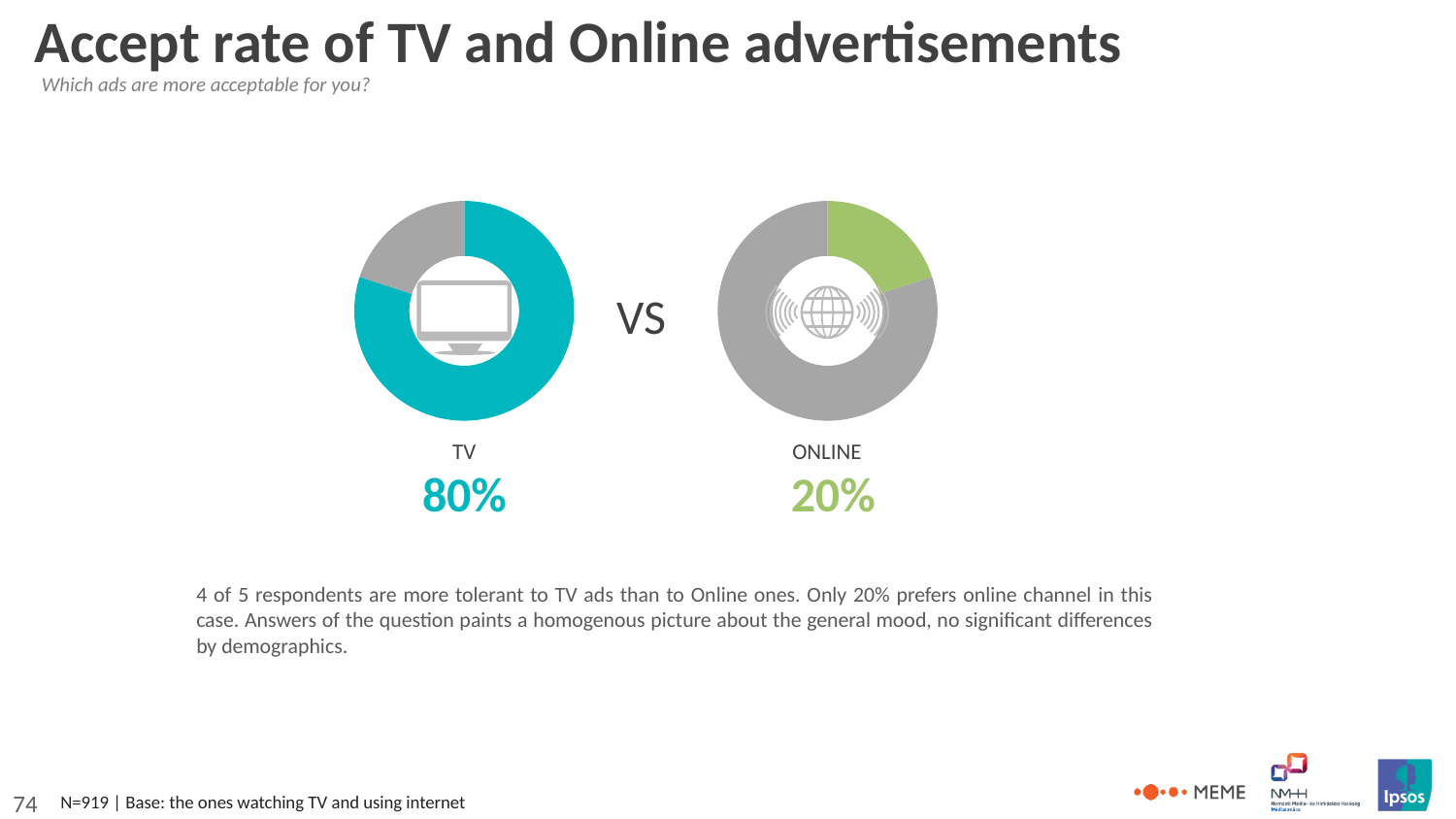
What share of the Online donut chart is filled with the coloured (green) segment? 20% What is the title of the slide containing the charts? Accept rate of TV and Online advertisements What is the accept rate shown for TV advertisements? 80% Which channel has the lower accept rate? Online What colour is the highlighted segment of the Online donut chart? Green What is the sample size (N) stated for the charts? N=919 What kind of chart is used to show the TV and Online accept rates? Donut (pie) chart Which channel has the higher accept rate, TV or Online? TV How many donut charts are shown on the slide? 2 What is the difference in percentage points between the TV accept rate and the Online accept rate? 60 percentage points What share of the TV donut chart is filled with the coloured (teal) segment? 80% What is the accept rate shown for Online advertisements? 20%